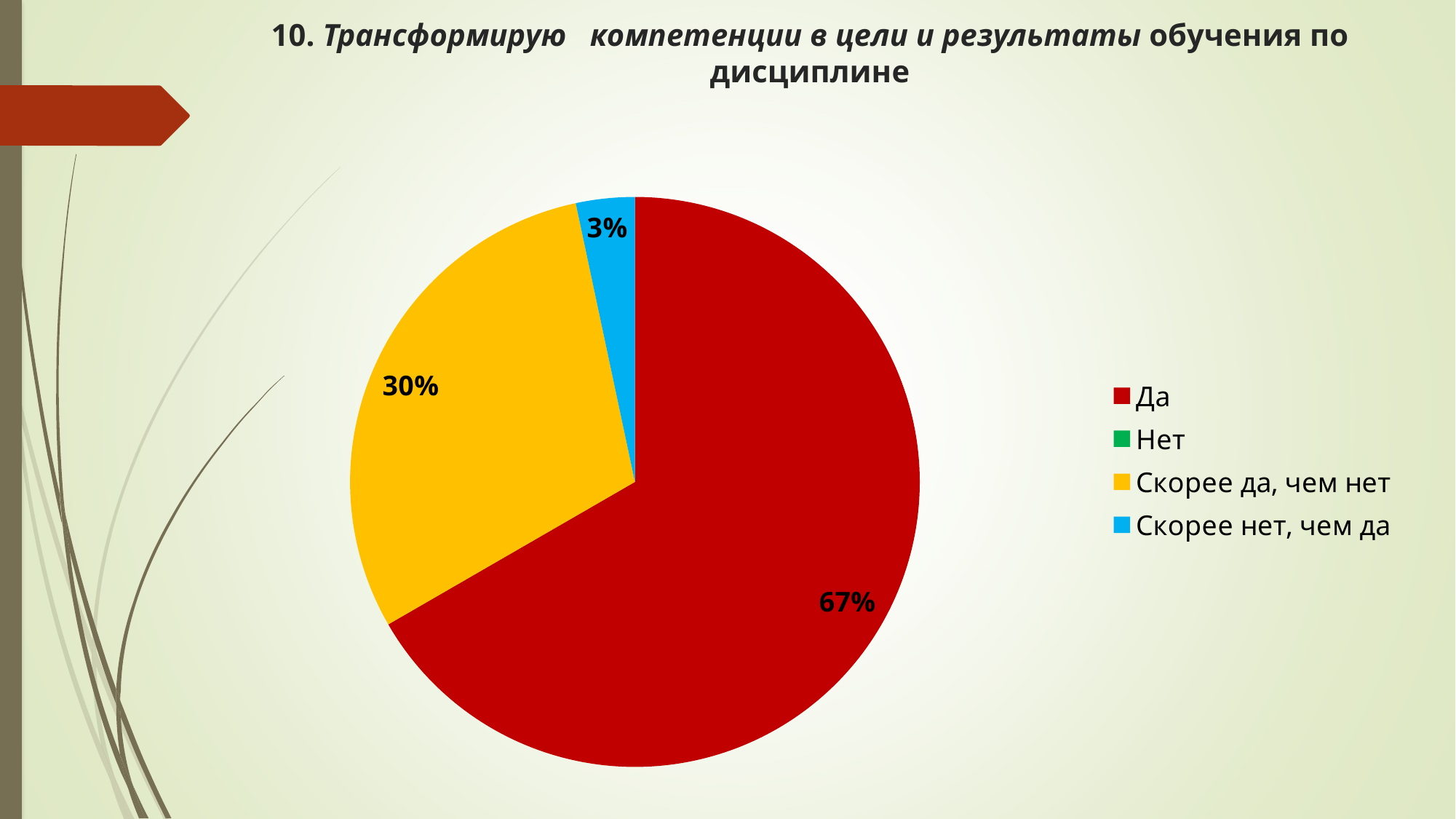
Which category has the largest slice of the pie? Да What kind of chart is shown on the slide? pie chart What is the difference in percentage points between "Скорее да, чем нет" and "Скорее нет, чем да"? 27 What share of the pie does "Да" take? 67% Which is larger: the slice for "Да" or the slice for "Скорее да, чем нет"? Да Which legend entry has no visible slice in the pie? Нет What share of the pie does "Скорее да, чем нет" take? 30% How many entries does the legend list? 4 What is the difference in percentage points between "Да" and "Скорее да, чем нет"? 37 Which labelled slice of the pie is the smallest? Скорее нет, чем да What colour is the slice for "Скорее нет, чем да"? blue What share of the pie does "Скорее нет, чем да" take? 3%